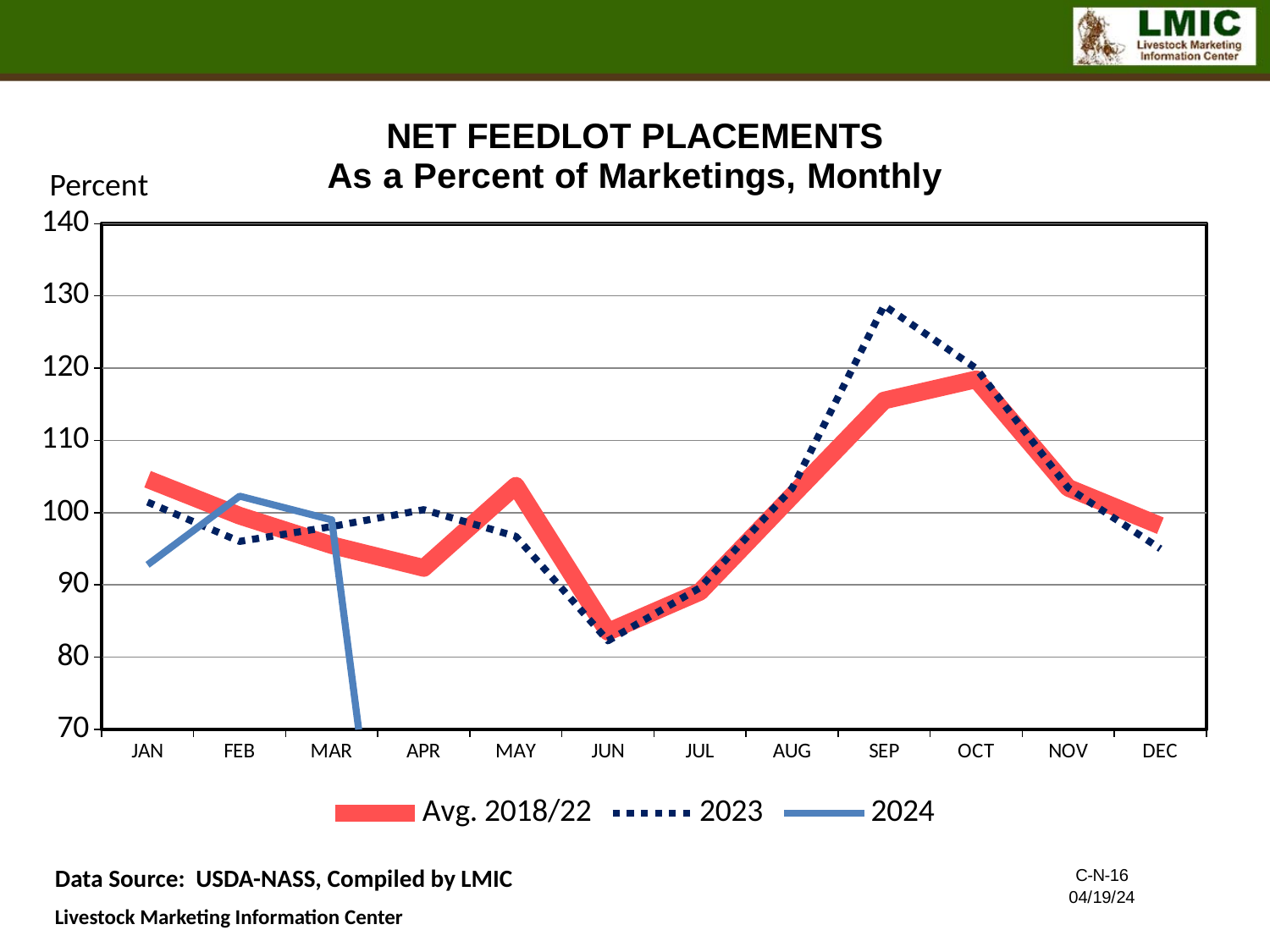
Is the 2023 value for SEP greater or less than 120? greater How many months are shown along the x axis? 12 What kind of chart is shown on the slide? line chart Is the Avg. 2018/22 value for JUN greater or less than 90? less In JAN, which series is higher: Avg. 2018/22 or 2024? Avg. 2018/22 How many series does the legend list? 3 Does the Avg. 2018/22 series rise or fall from JUN to OCT? rise In which month does the 2023 series reach its highest value? SEP In SEP, which series is higher: 2023 or Avg. 2018/22? 2023 In which month does the Avg. 2018/22 series reach its highest value? OCT Is the 2024 value for JAN greater or less than 100? less In which month does the 2023 series reach its lowest value? JUN